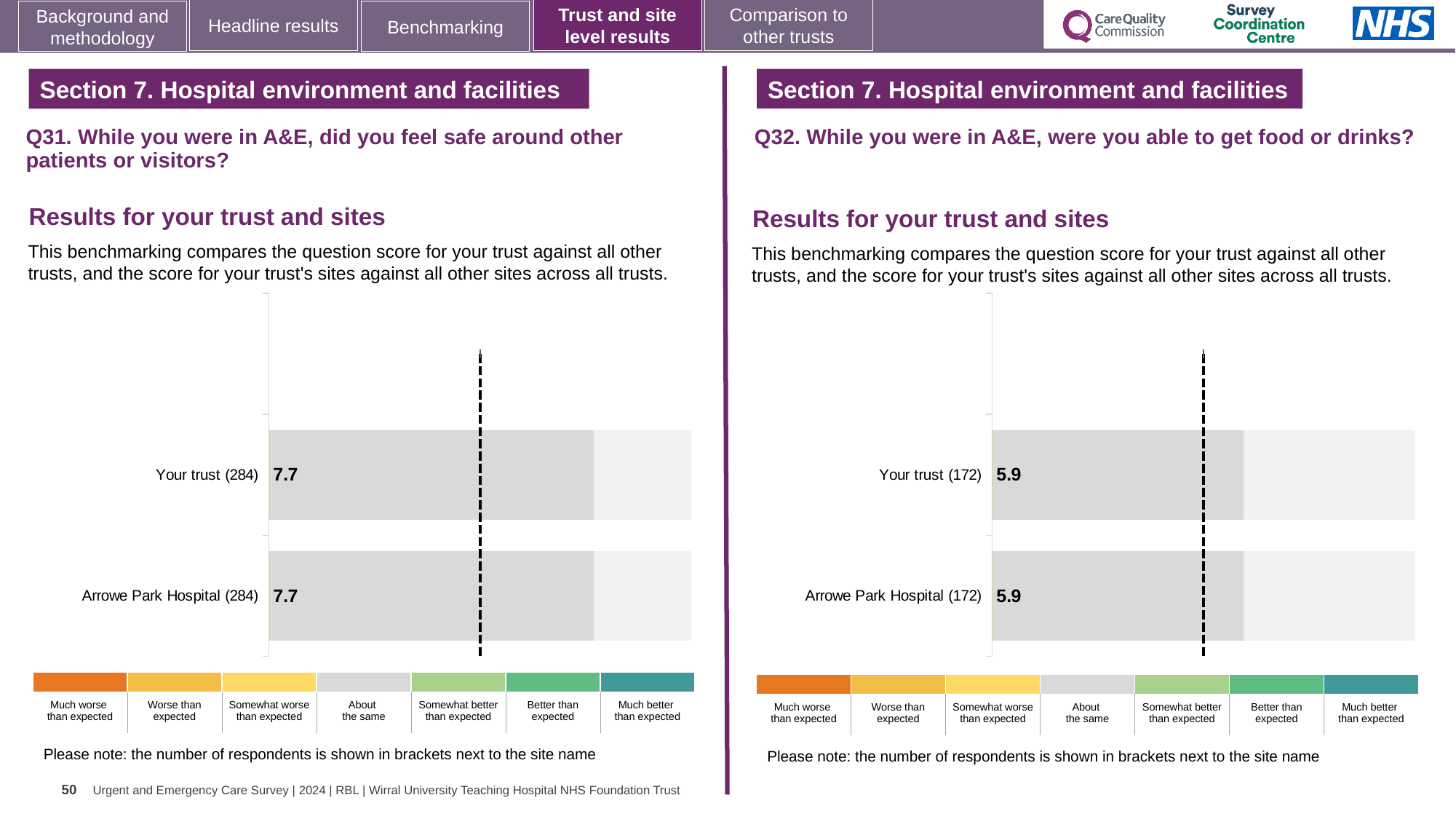
On the Q31 chart (left), what is the difference between the score for Your trust and the score for Arrowe Park Hospital? 0 What kind of chart is the Q31 chart (left)? Bar chart On the Q32 chart (right), what is the score for Arrowe Park Hospital? 5.9 How many bars are plotted on the Q32 chart (right)? 2 On the Q31 chart (left), what is the score for Arrowe Park Hospital? 7.7 On the Q31 chart (left), how many respondents are shown in brackets next to Your trust? 284 On the Q31 chart (left), what is the score for Your trust? 7.7 What is the difference between the Your trust score on the Q31 chart (left) and the Your trust score on the Q32 chart (right)? 1.8 Is the Your trust score on the Q32 chart (right) larger or smaller than the Your trust score on the Q31 chart (left)? Smaller On the Q32 chart (right), what is the score for Your trust? 5.9 On the Q32 chart (right), how many respondents are shown in brackets next to Arrowe Park Hospital? 172